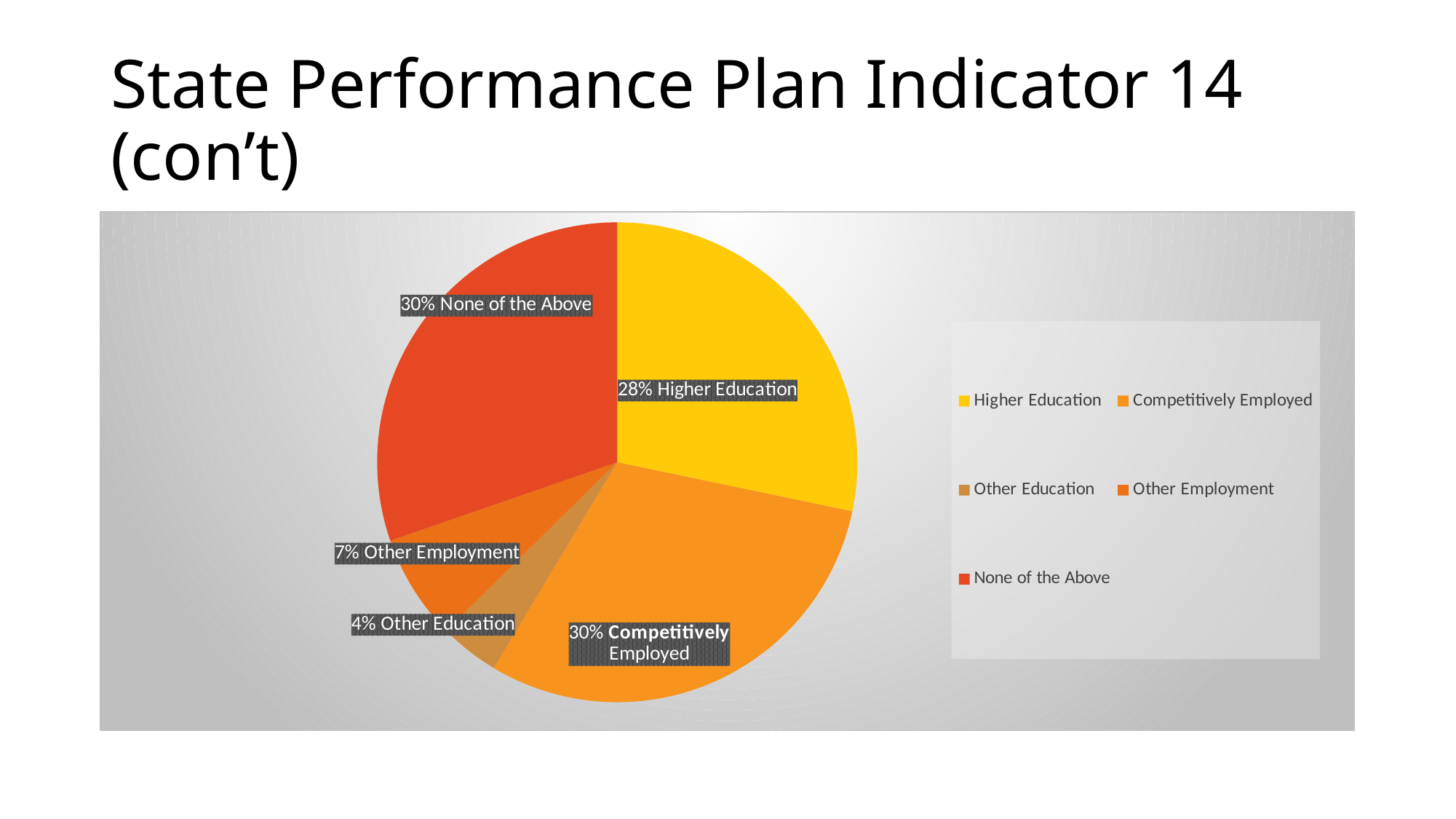
What is the difference in percentage points between Higher Education and Other Employment? 21 What share of the pie is Other Education? 4% How many slices does the pie chart have? 5 What colour is the Higher Education slice? yellow What share of the pie is None of the Above? 30% Which is larger, the Other Employment slice or the Other Education slice? Other Employment What share of the pie is Higher Education? 28% Which category has the smallest slice of the pie? Other Education How many entries does the legend list? 5 What kind of chart is shown on the slide? pie chart